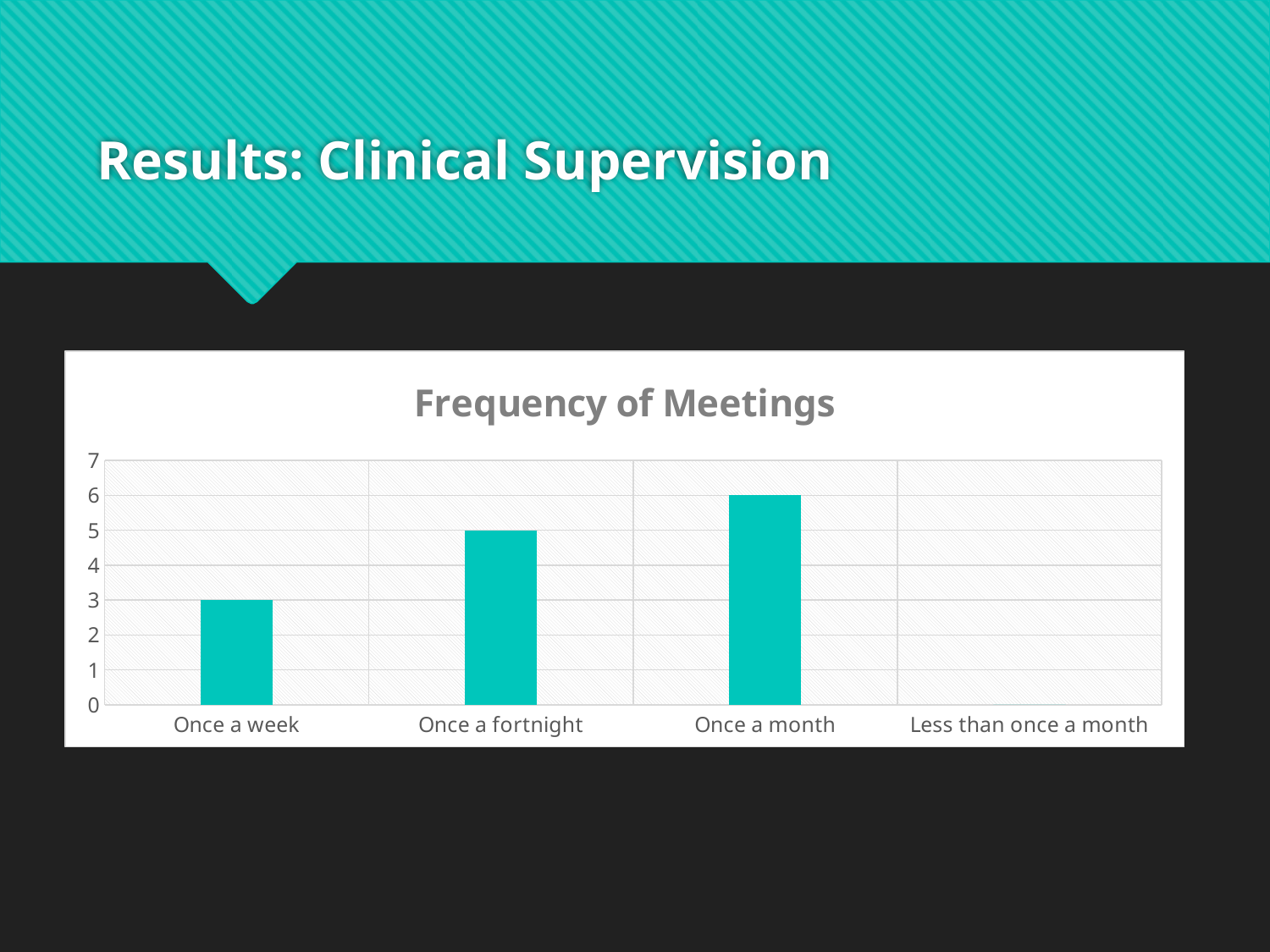
What is the value for Once a week? 3 What is the value for Once a month? 6 Is the value for Once a month greater or less than 4? greater Which category has the highest value? Once a month Which category has the lowest value? Less than once a month How many categories are shown on the x axis of the chart? 4 What kind of chart is shown on the slide? bar chart Which is larger, the value for Once a fortnight or the value for Once a week? Once a fortnight What is the title of the chart? Frequency of Meetings What is the value for Once a fortnight? 5 What is the value for Less than once a month? 0 What is the difference between the values for Once a month and Once a week? 3